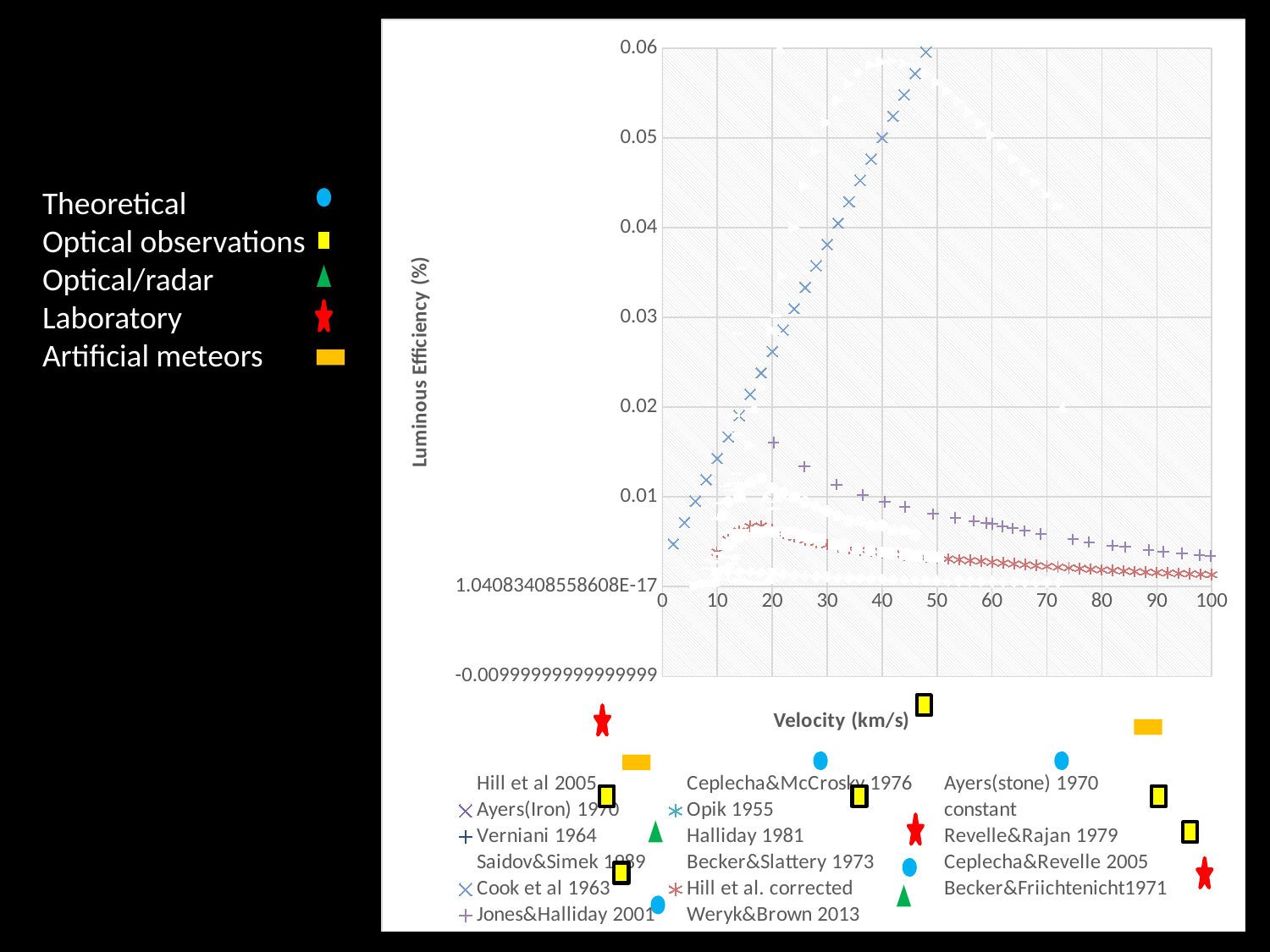
What kind of chart is shown on the slide? scatter chart Does the Jones&Halliday 2001 series rise or fall as velocity increases from 30 to 100 km/s? fall What is the title of the horizontal axis of the chart? Velocity (km/s) Is the value of the Hill et al. corrected series at a velocity of 100 km/s greater or less than 0.01? less Is the value of the Jones&Halliday 2001 series at a velocity of 100 km/s greater or less than 0.01? less How many series does the chart legend list? 17 What is the maximum value shown on the horizontal axis of the chart? 100 At a velocity of 40 km/s, which series has the larger value: Cook et al 1963 or Jones&Halliday 2001? Cook et al 1963 Does the Cook et al 1963 series rise or fall as velocity increases from 10 to 40 km/s? rise What is the title of the vertical axis of the chart? Luminous Efficiency (%) Is the value of the Cook et al 1963 series at a velocity of 30 km/s greater or less than 0.03? greater